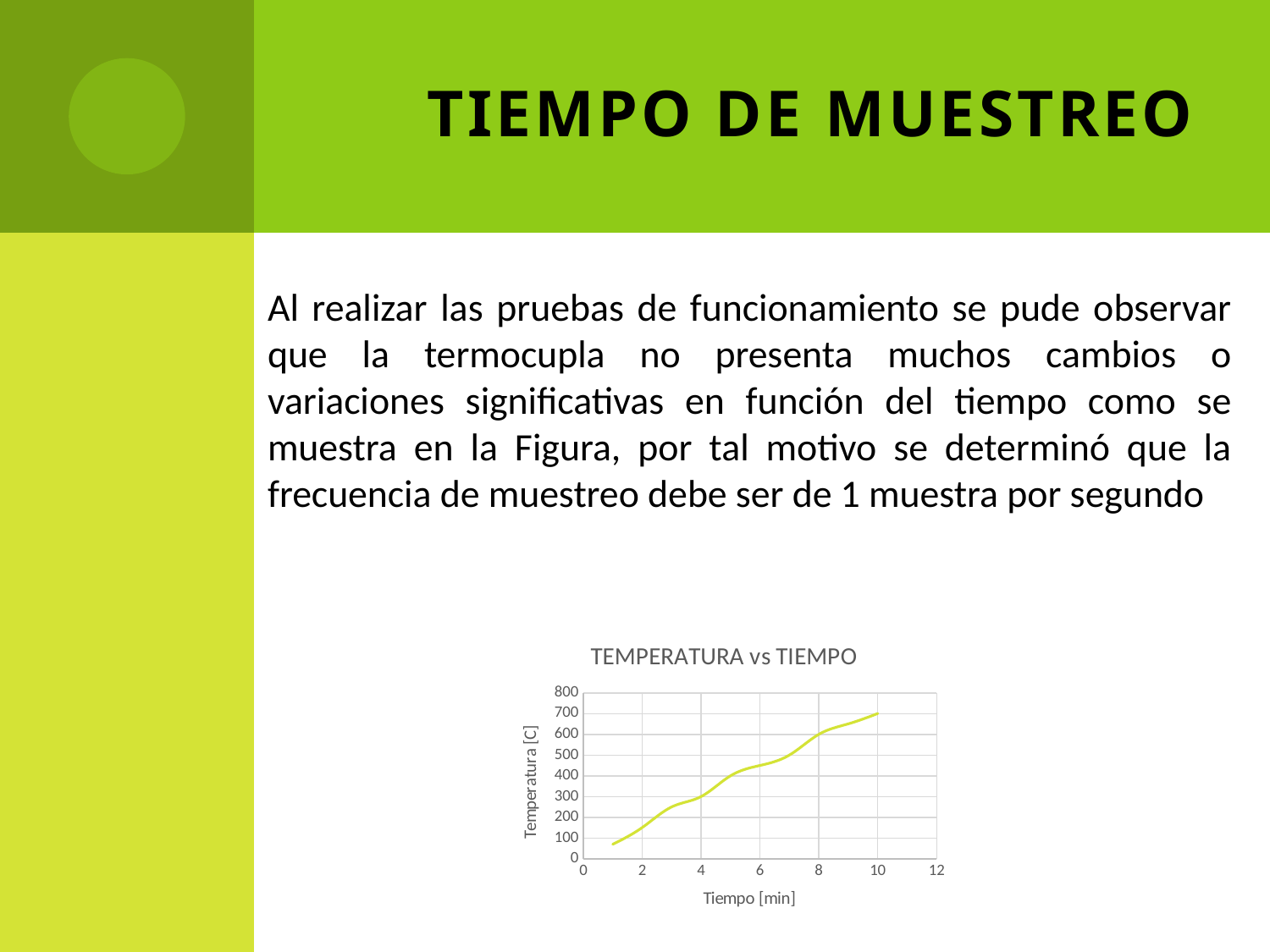
What is the label of the x axis of the chart? Tiempo [min] Is the temperature at 6 min greater or less than 500? less What kind of chart is shown on the slide? line chart Is the temperature at 6 min greater or less than 400? greater Does the temperature rise or fall as time increases along the x axis? rise Is the temperature at 2 min greater or less than 200? less What is the title of the chart on the slide? TEMPERATURA vs TIEMPO What is the highest value shown on the y axis of the chart? 800